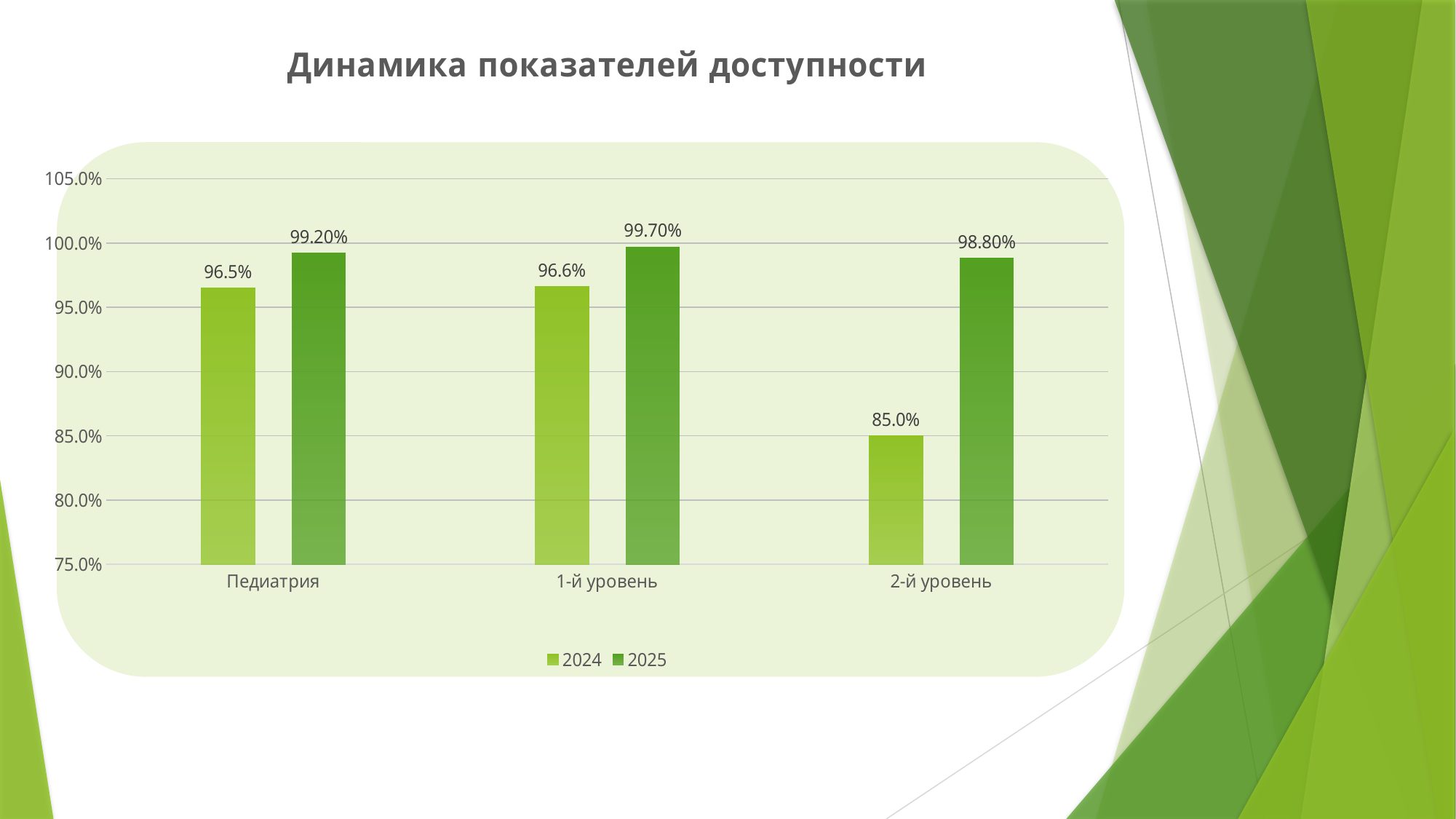
How many series does the legend list? 2 What type of chart is shown on the slide? Bar chart Which category has the highest value in the 2025 series? 1-й уровень What is the value for 1-й уровень in the 2025 series? 99.70% What is the value for Педиатрия in the 2024 series? 96.5% Which is larger for Педиатрия: the 2024 value or the 2025 value? 2025 How many categories are shown on the x axis? 3 What is the value for 2-й уровень in the 2025 series? 98.80% Is the 2024 value for 2-й уровень greater or less than 90.0%? less What is the difference between the 2025 and 2024 values for 2-й уровень? 13.8 percentage points What is the value for 2-й уровень in the 2024 series? 85.0% Which category has the lowest value in the 2024 series? 2-й уровень